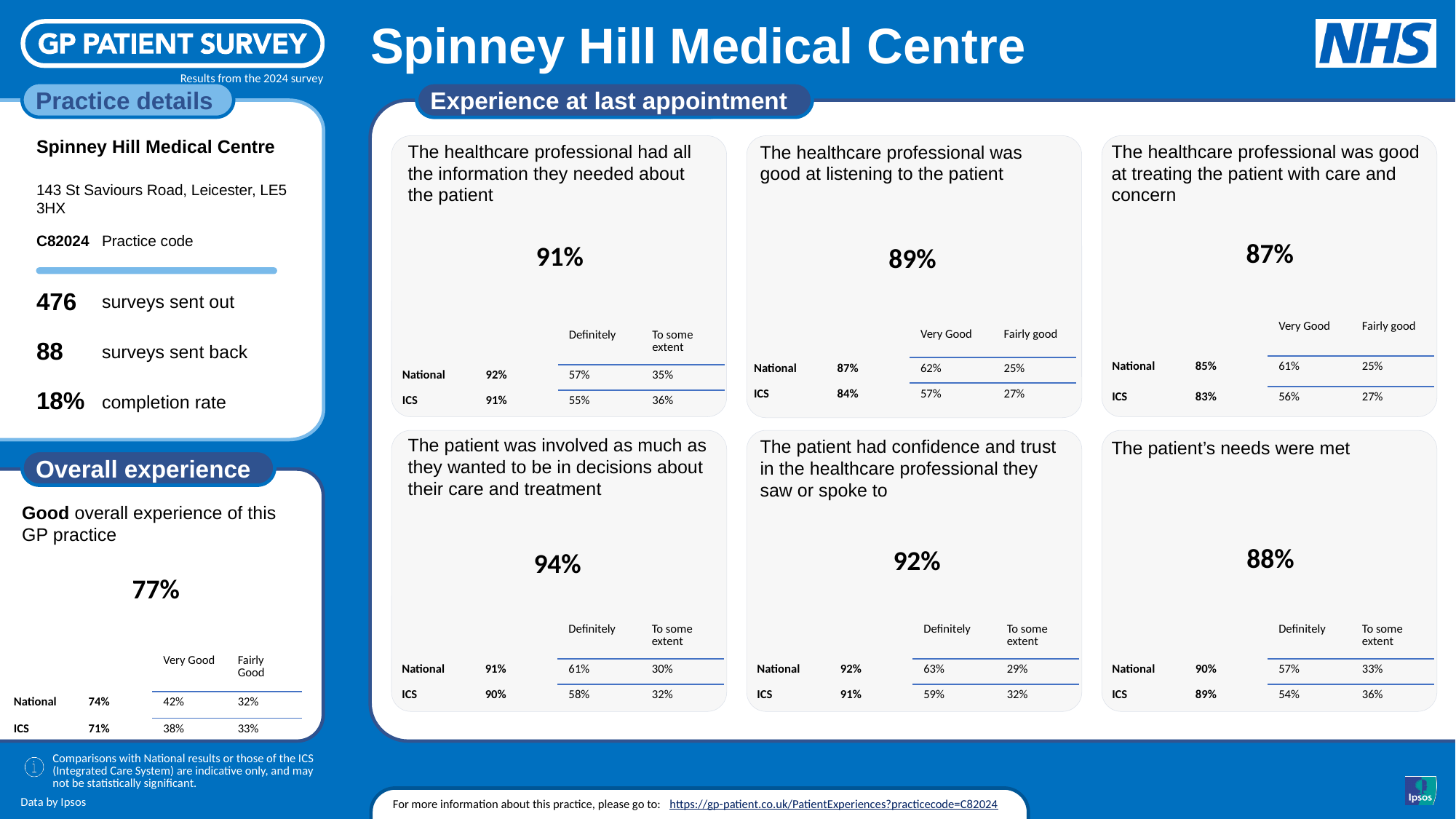
In the 'The healthcare professional was good at listening to the patient' panel, what is the National value? 87% In the 'Overall experience' panel, what is the practice's percentage for good overall experience? 77% In the 'The patient was involved as much as they wanted to be in decisions about their care and treatment' panel, what is the practice's headline percentage? 94% In the 'The patient's needs were met' panel, which is larger: the practice's headline percentage or the National value? the National value In the 'The patient had confidence and trust in the healthcare professional they saw or spoke to' panel, what is the National 'Definitely' value? 63% In the 'The healthcare professional was good at listening to the patient' panel, what is the difference between the National 'Very Good' value and the ICS 'Very Good' value? 5% Among the six 'Experience at last appointment' panels, which question has the lowest practice headline percentage? The healthcare professional was good at treating the patient with care and concern In the 'The patient's needs were met' panel, what is the ICS 'To some extent' value? 36% In the 'The healthcare professional had all the information they needed about the patient' panel, what is the practice's headline percentage? 91% In the 'Overall experience' panel, what is the difference between the practice's 77% and the National 74%? 3% Among the six 'Experience at last appointment' panels, which question has the highest practice headline percentage? The patient was involved as much as they wanted to be in decisions about their care and treatment In the 'The healthcare professional was good at treating the patient with care and concern' panel, what is the ICS value? 83%